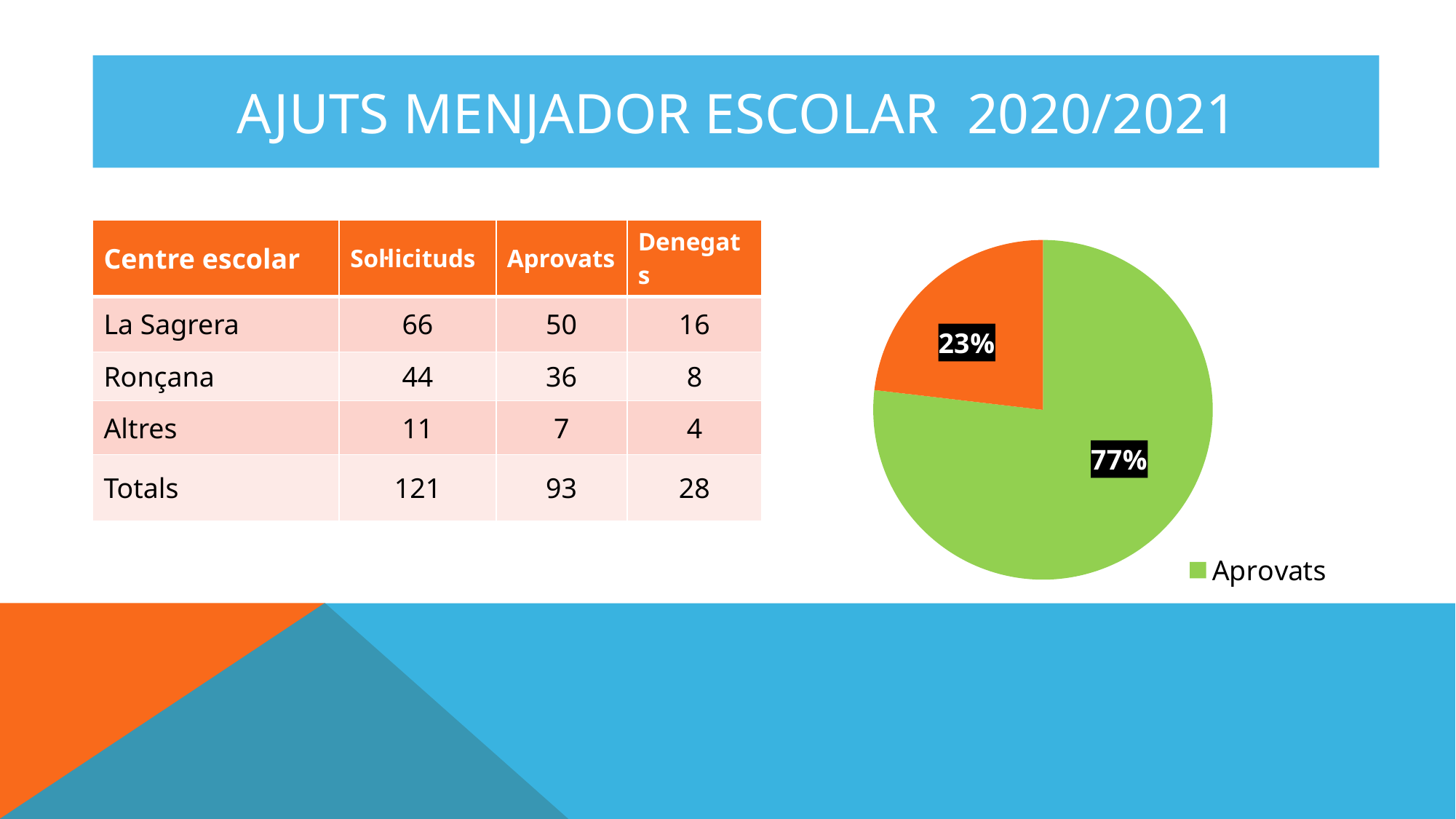
What percentage is shown on the orange slice of the pie chart? 23% What colour is the Aprovats slice in the pie chart? green Which slice of the pie chart is the largest? Aprovats How many slices does the pie chart have? 2 Which slice of the pie chart is the smallest, the green one or the orange one? the orange one What is the legend entry shown for the pie chart? Aprovats Is the green slice of the pie chart larger or smaller than the orange slice? larger How many entries does the legend of the pie chart list? 1 What percentage is shown on the green slice of the pie chart? 77% What is the difference in percentage points between the green slice and the orange slice of the pie chart? 54 What share of the pie chart does the Aprovats slice represent? 77% What kind of chart is shown on the slide? pie chart